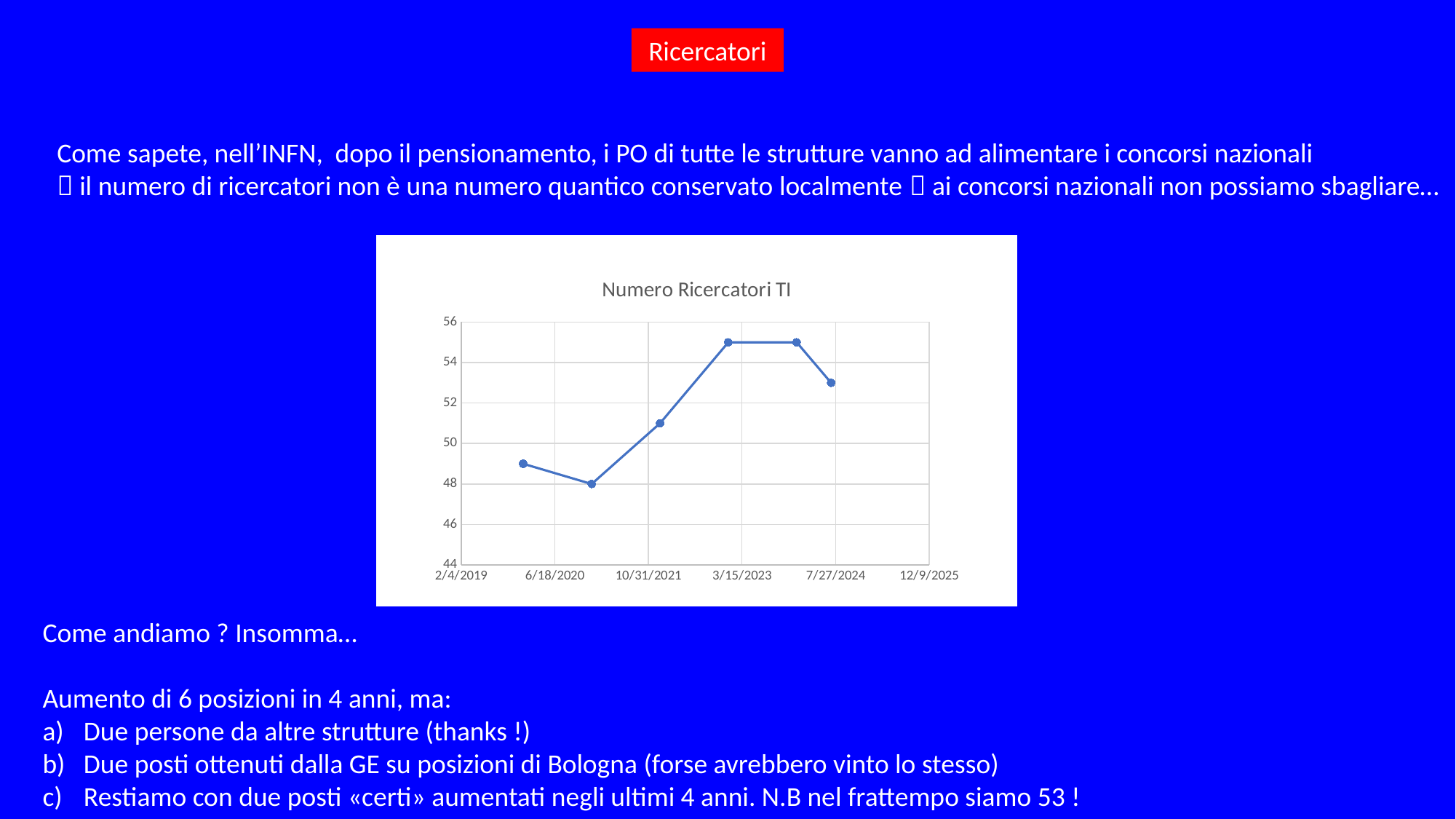
What is the value of the second (lowest) data point on the line, which lands on an axis gridline? 48 Is the value of the last data point on the line greater or less than 52? greater Does the line rise or fall between the second and fourth data points? rise Which is larger, the first data point or the last data point on the line? the last data point What kind of chart is shown on the slide? line chart What is the maximum value shown on the vertical axis of the chart? 56 What is the title of the chart? Numero Ricercatori TI Is the value of the third data point on the line greater or less than 50? greater Is the value of the first data point on the line greater or less than 50? less Does the line rise or fall between the fifth and sixth data points? fall How many data points are plotted on the line in the chart? 6